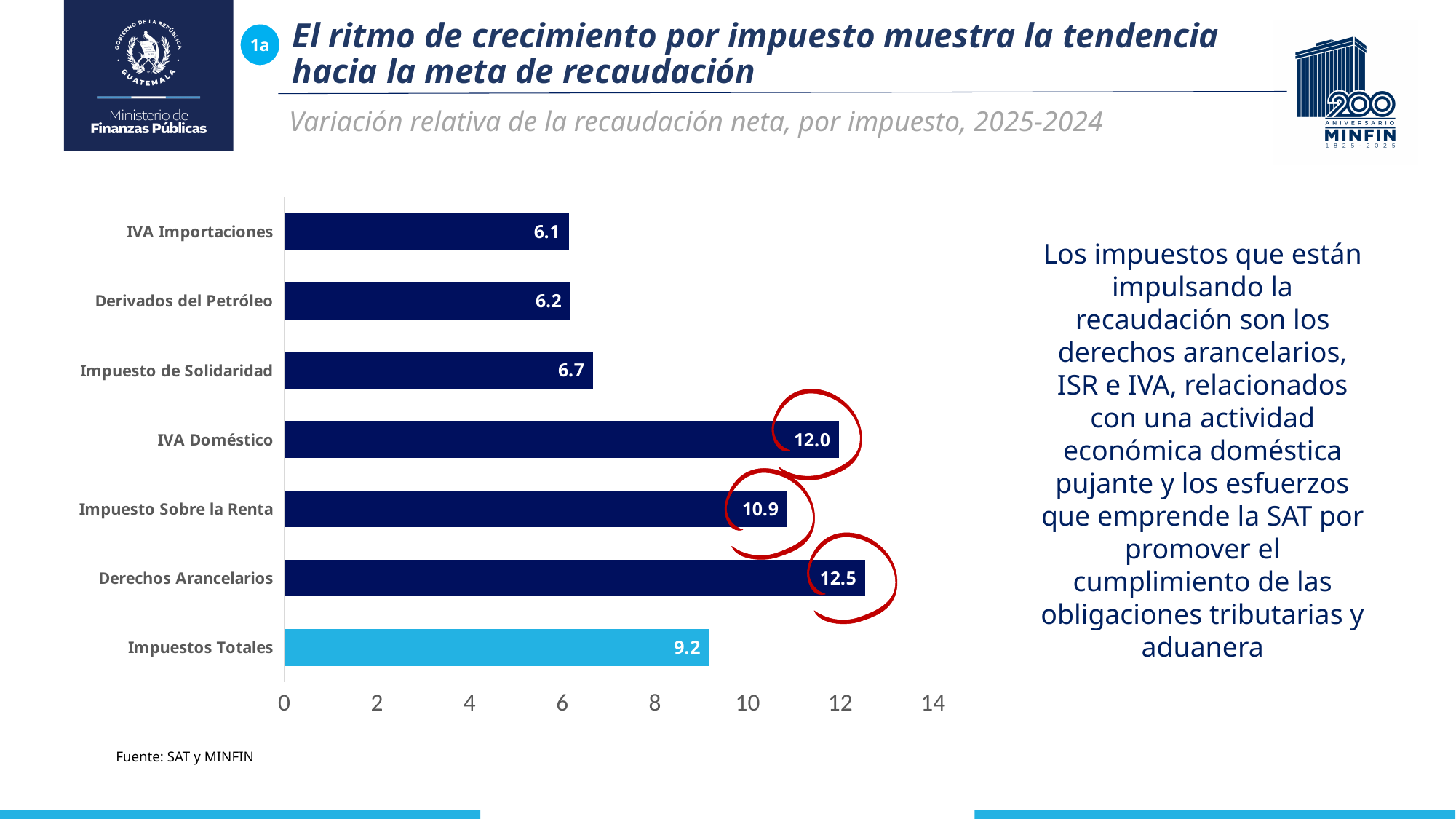
Which is larger, IVA Doméstico or Impuesto Sobre la Renta? IVA Doméstico What kind of chart is shown on the slide? bar chart Which category has the lowest value? IVA Importaciones Is the value for Derivados del Petróleo greater or less than 8? less What is the value for IVA Doméstico? 12.0 What is the difference between Impuestos Totales and IVA Importaciones? 3.1 Which bar is shown in a lighter blue colour than the others? Impuestos Totales What is the difference between Derechos Arancelarios and Impuesto Sobre la Renta? 1.6 How many categories are shown in the chart? 7 What is the value for Impuestos Totales? 9.2 Which category has the highest value? Derechos Arancelarios What is the value for Impuesto de Solidaridad? 6.7